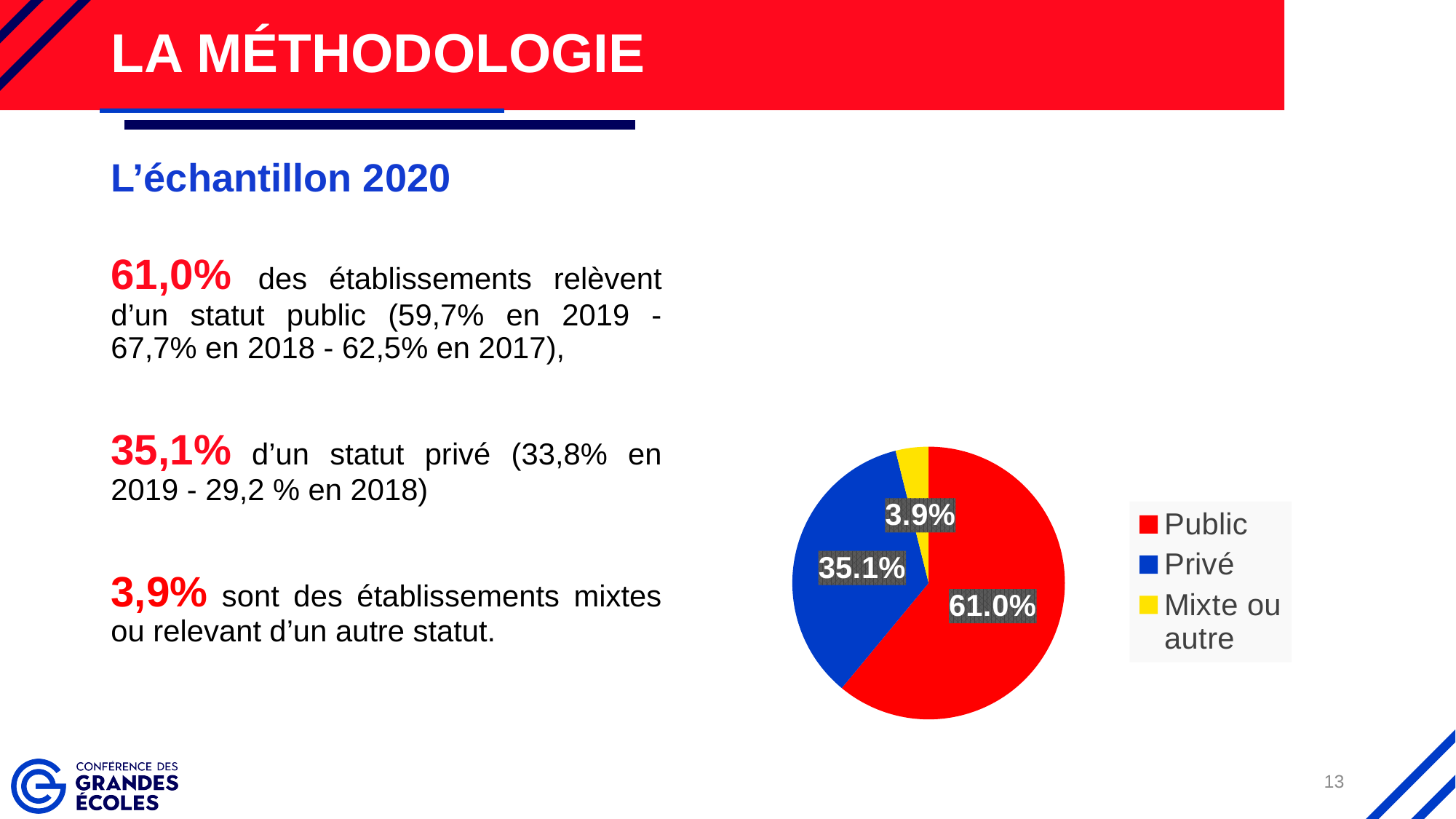
What is the difference in percentage points between the Privé and Mixte ou autre slices? 31.2 What colour is the Privé slice in the pie chart? blue What is the difference in percentage points between the Public and Privé slices? 25.9 What share of the pie does the Public slice represent? 61.0% What kind of chart is shown on the slide? pie chart How many entries does the legend list? 3 Which category has the smallest slice of the pie? Mixte ou autre How many slices does the pie chart have? 3 Which slice is larger, Privé or Mixte ou autre? Privé What share of the pie does the Mixte ou autre slice represent? 3.9% Which category has the largest slice of the pie? Public What share of the pie does the Privé slice represent? 35.1%